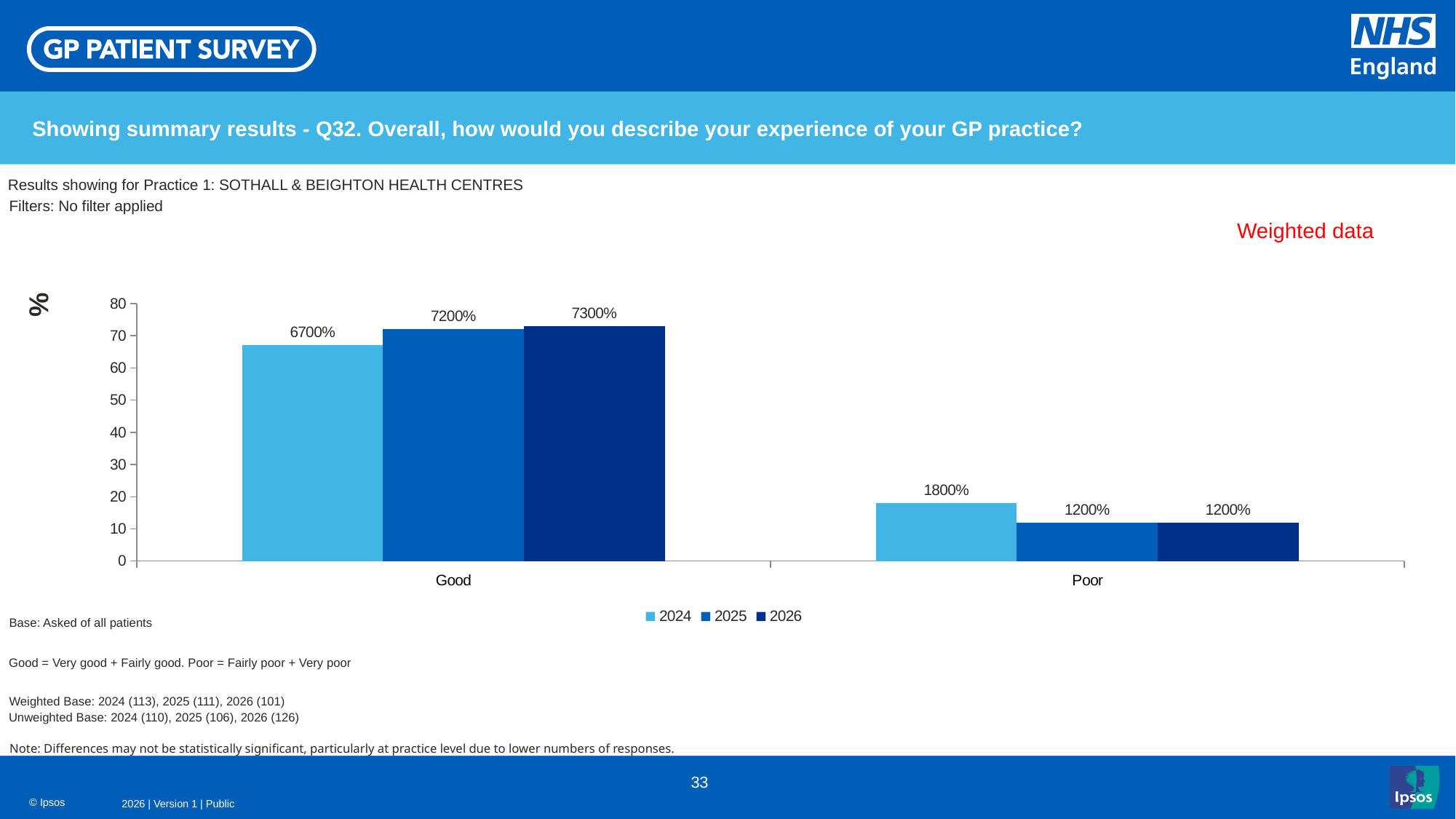
What is the data label shown for 2026 in the Good category? 7300% Which year has the lowest bar in the Good category? 2024 Which years are listed in the chart legend? 2024, 2025, 2026 What kind of chart is shown on the slide? bar chart What is the data label shown for 2024 in the Poor category? 1800% What is the data label shown for 2024 in the Good category? 6700% Which year has the highest bar in the Poor category? 2024 How many categories are shown on the x axis? 2 Is the 2025 bar for Good larger or smaller than the 2024 bar for Good? larger What is the data label shown for 2025 in the Poor category? 1200% How many series does the legend list? 3 Which year has the highest bar in the Good category? 2026